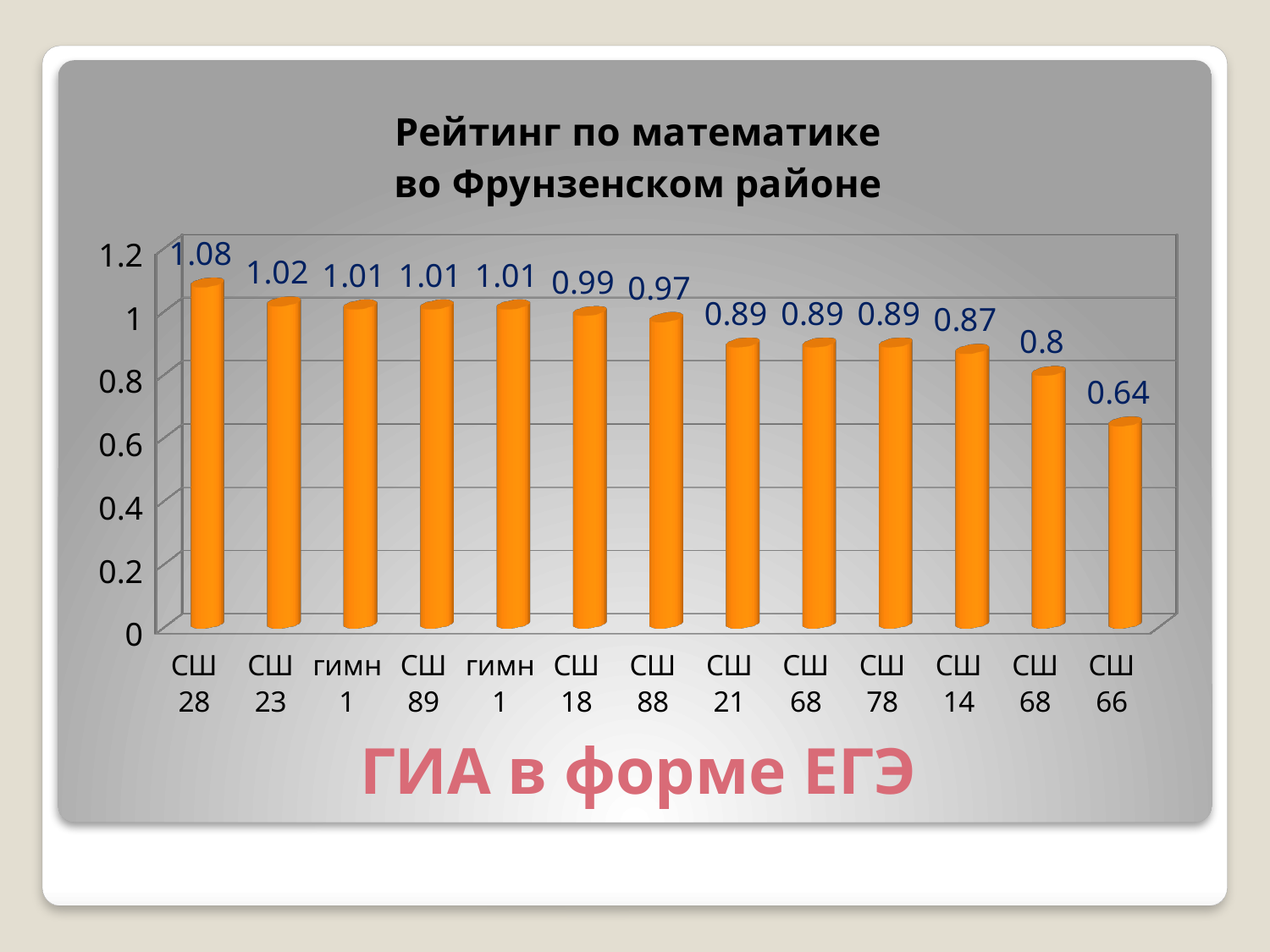
What is the difference between the values for СШ 28 and СШ 66? 0.44 What is the value for СШ 88? 0.97 What is the value for СШ 28? 1.08 Which category has the highest value? СШ 28 Do the values rise or fall from left to right along the x axis? fall How many bars are shown in the chart? 13 What kind of chart is shown on the slide? bar chart Which category has the lowest value? СШ 66 Which is larger, the value for СШ 18 or the value for СШ 21? СШ 18 What is the value for СШ 14? 0.87 What is the value for СШ 66? 0.64 Is the value for СШ 66 greater or less than 0.8? less